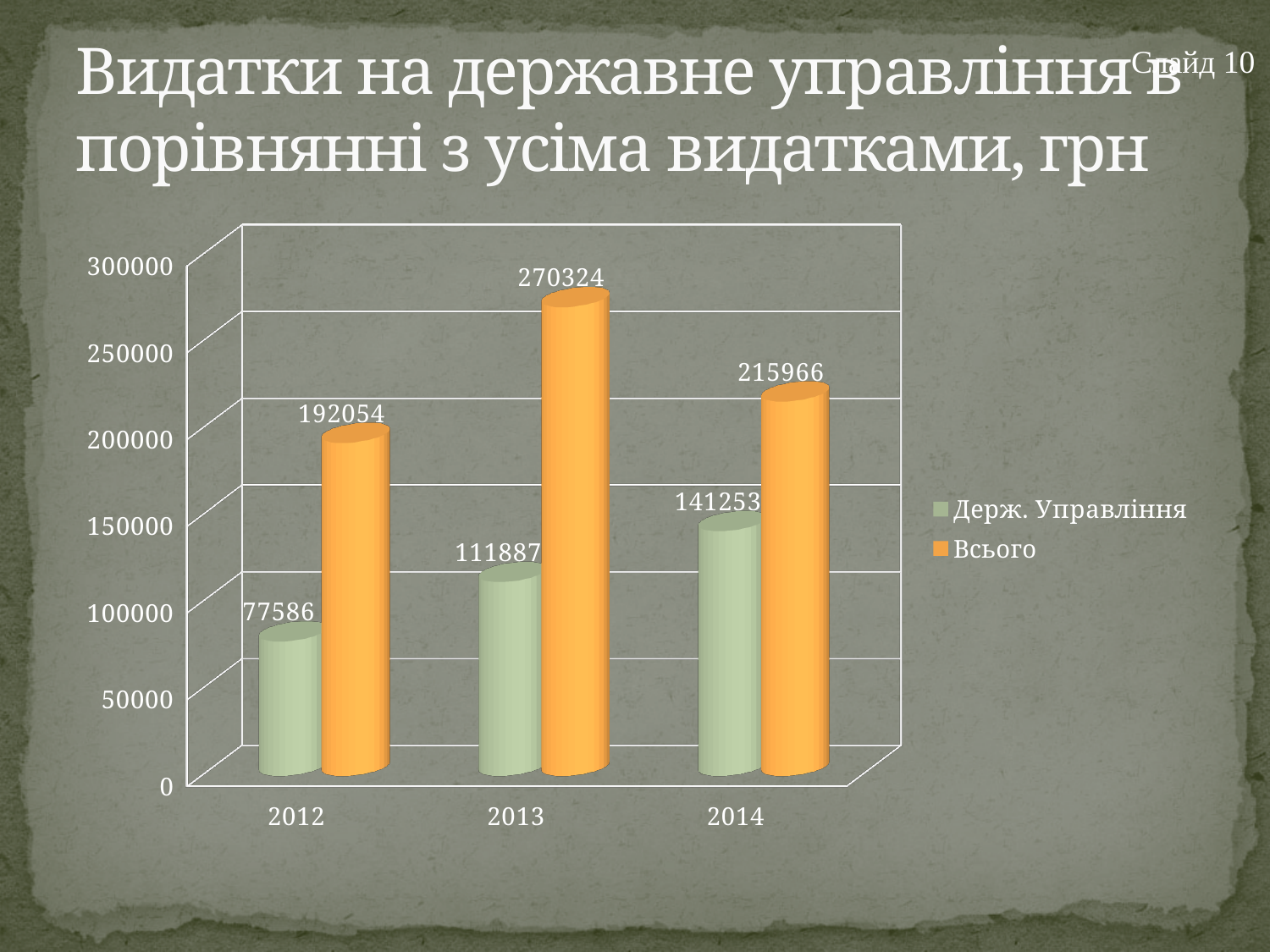
How many series does the legend list? 2 Which is larger: Всього in 2013 or Всього in 2014? Всього in 2013 What is the value for Всього in 2014? 215966 What is the value for Держ. Управління in 2012? 77586 In which year is the Всього value highest? 2013 What is the value for Всього in 2013? 270324 What is the value for Держ. Управління in 2014? 141253 In which year is the Держ. Управління value lowest? 2012 What is the difference between Всього and Держ. Управління in 2012? 114468 Is the value for Держ. Управління in 2013 greater or less than 100000? greater How many years are shown on the x axis? 3 Does the Держ. Управління value rise or fall from 2012 to 2014? rise